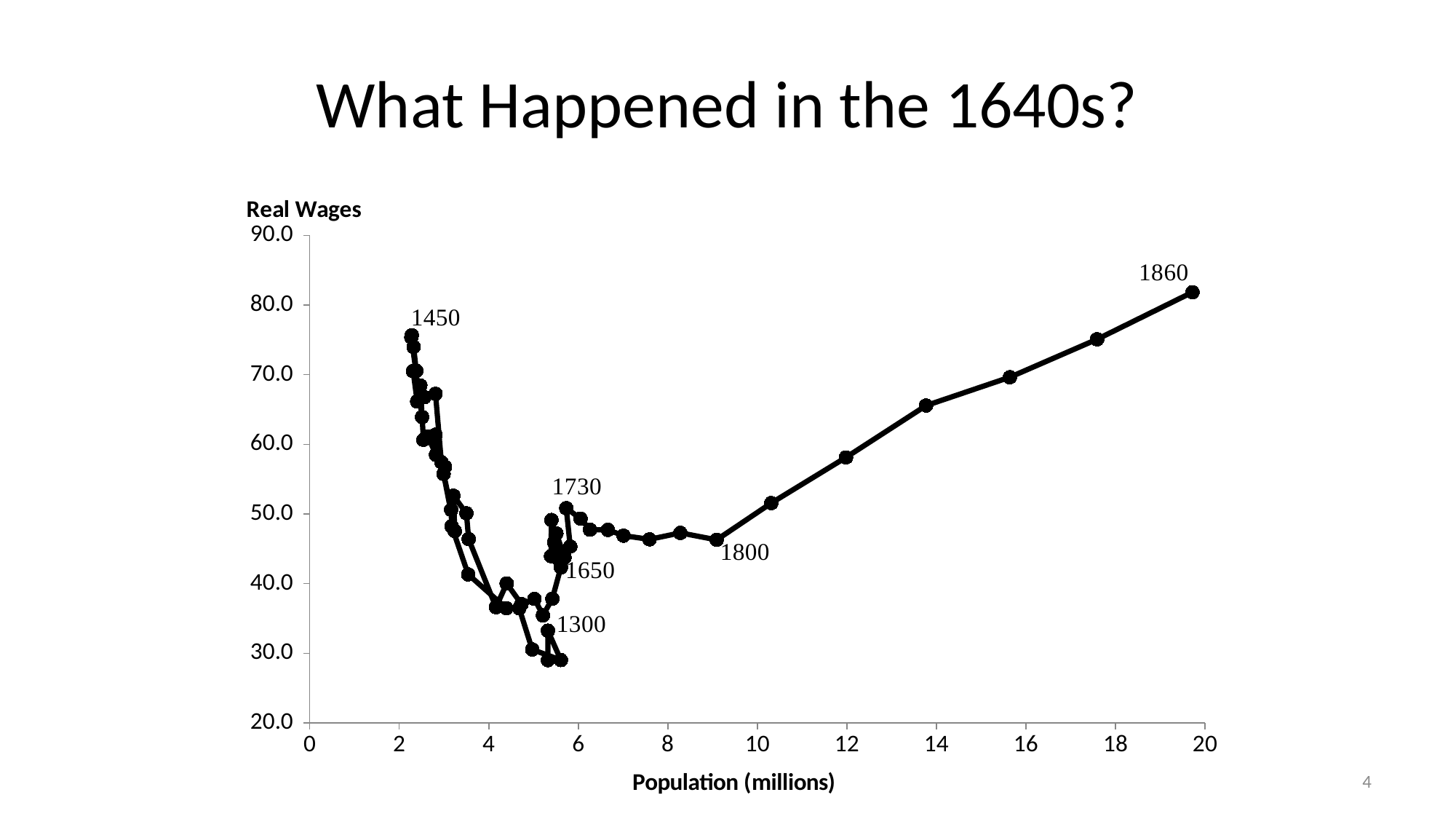
Is the real wage value for the point labelled 1860 greater or less than 70? greater Which of the labelled years, 1300 or 1730, has the lower real wage value? 1300 Is the real wage value for the point labelled 1300 greater or less than 40? less Is the population for the point labelled 1860 greater or less than 18 million? greater How many points on the chart are labelled with a year? 6 What is the label of the horizontal axis? Population (millions) What kind of chart is shown on the slide? line chart (connected scatter plot) Which of the labelled years, 1450 or 1860, has the higher real wage value? 1860 What is the label of the vertical axis? Real Wages